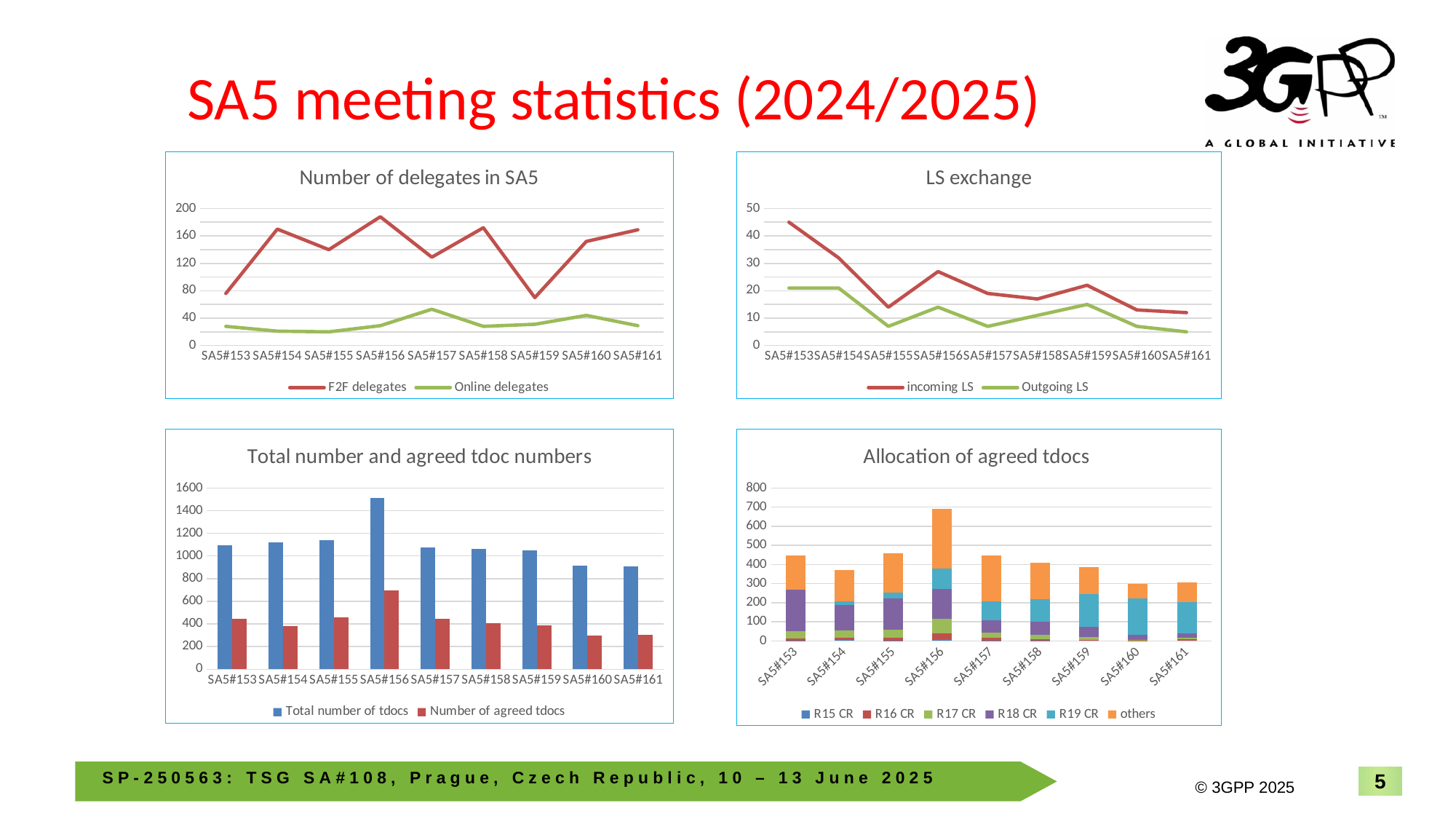
In the "LS exchange" chart, at which meeting is the number of incoming LS highest? SA5#153 In the "LS exchange" chart, is the value for Outgoing LS at SA5#161 greater or less than 10? less In the "Number of delegates in SA5" chart, is the value for F2F delegates at SA5#156 greater or less than 160? greater In the "Number of delegates in SA5" chart, at which meeting is the number of F2F delegates highest? SA5#156 In the "Number of delegates in SA5" chart, at which meeting is the number of Online delegates highest? SA5#157 In the "LS exchange" chart, which is larger at SA5#153: incoming LS or Outgoing LS? incoming LS In the "Allocation of agreed tdocs" chart, how many meetings are shown on the x axis? 9 How many series does the legend of the "Allocation of agreed tdocs" chart list? 6 What kind of chart is "Total number and agreed tdoc numbers"? bar chart What kind of chart is "Number of delegates in SA5"? line chart In the "Total number and agreed tdoc numbers" chart, is the Total number of tdocs at SA5#156 greater or less than 1400? greater